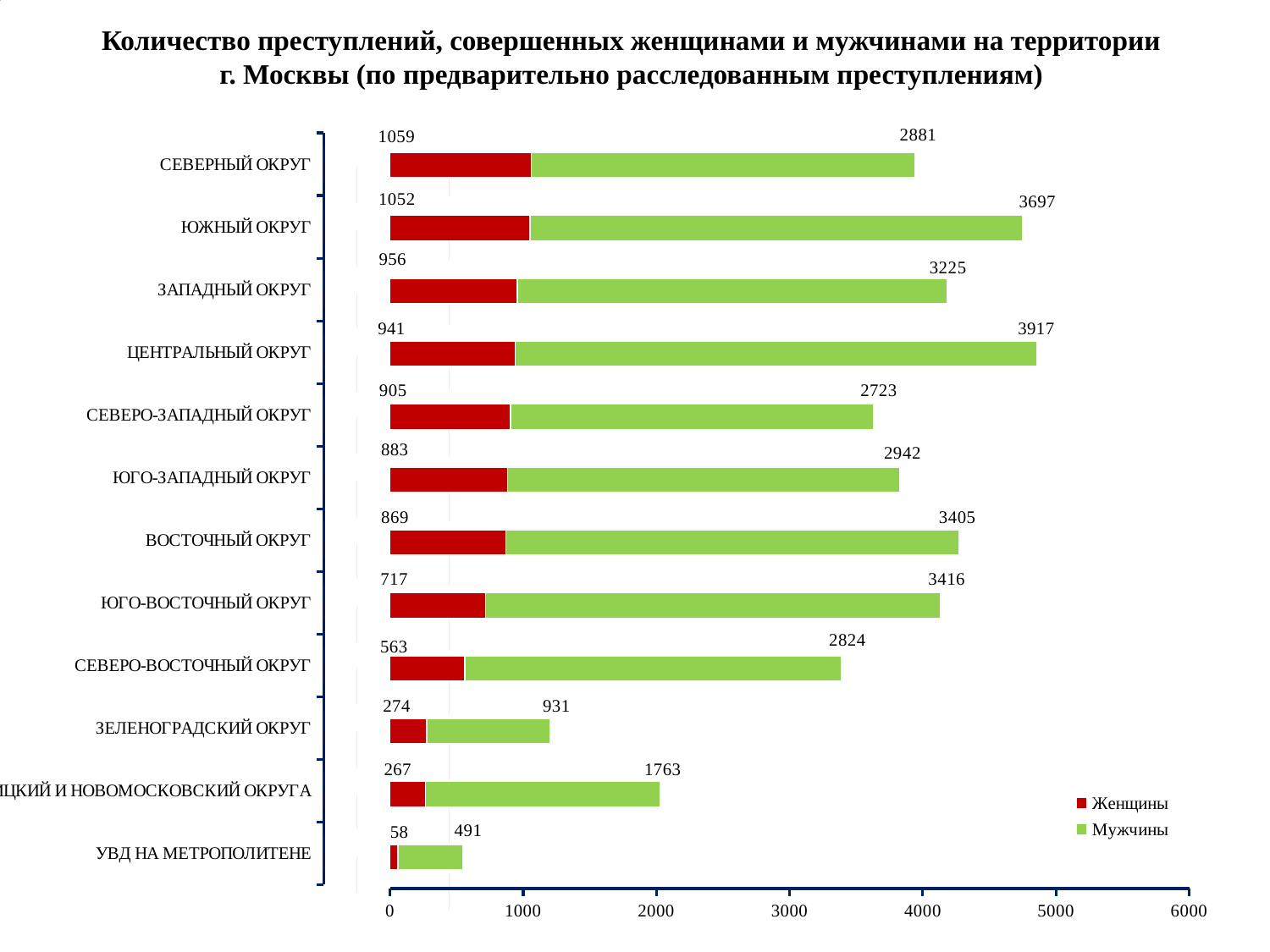
Which category has the highest value for Мужчины? ЦЕНТРАЛЬНЫЙ ОКРУГ Is the total length of the stacked bar for ЦЕНТРАЛЬНЫЙ ОКРУГ greater or less than 4000? greater What is the value for Женщины in СЕВЕРНЫЙ ОКРУГ? 1059 What kind of chart is shown on the slide? Stacked bar chart Which category has the lowest value for Женщины? УВД НА МЕТРОПОЛИТЕНЕ How many series does the legend list? 2 Which has the larger Мужчины value: ВОСТОЧНЫЙ ОКРУГ or ЮГО-ВОСТОЧНЫЙ ОКРУГ? ЮГО-ВОСТОЧНЫЙ ОКРУГ What colour represents the Женщины series? Red What is the difference between the Мужчины values for ЮЖНЫЙ ОКРУГ and ЗАПАДНЫЙ ОКРУГ? 472 What is the total of the stacked bar for ЗЕЛЕНОГРАДСКИЙ ОКРУГ? 1205 What is the value for Мужчины in ЦЕНТРАЛЬНЫЙ ОКРУГ? 3917 How many categories are shown on the chart? 12